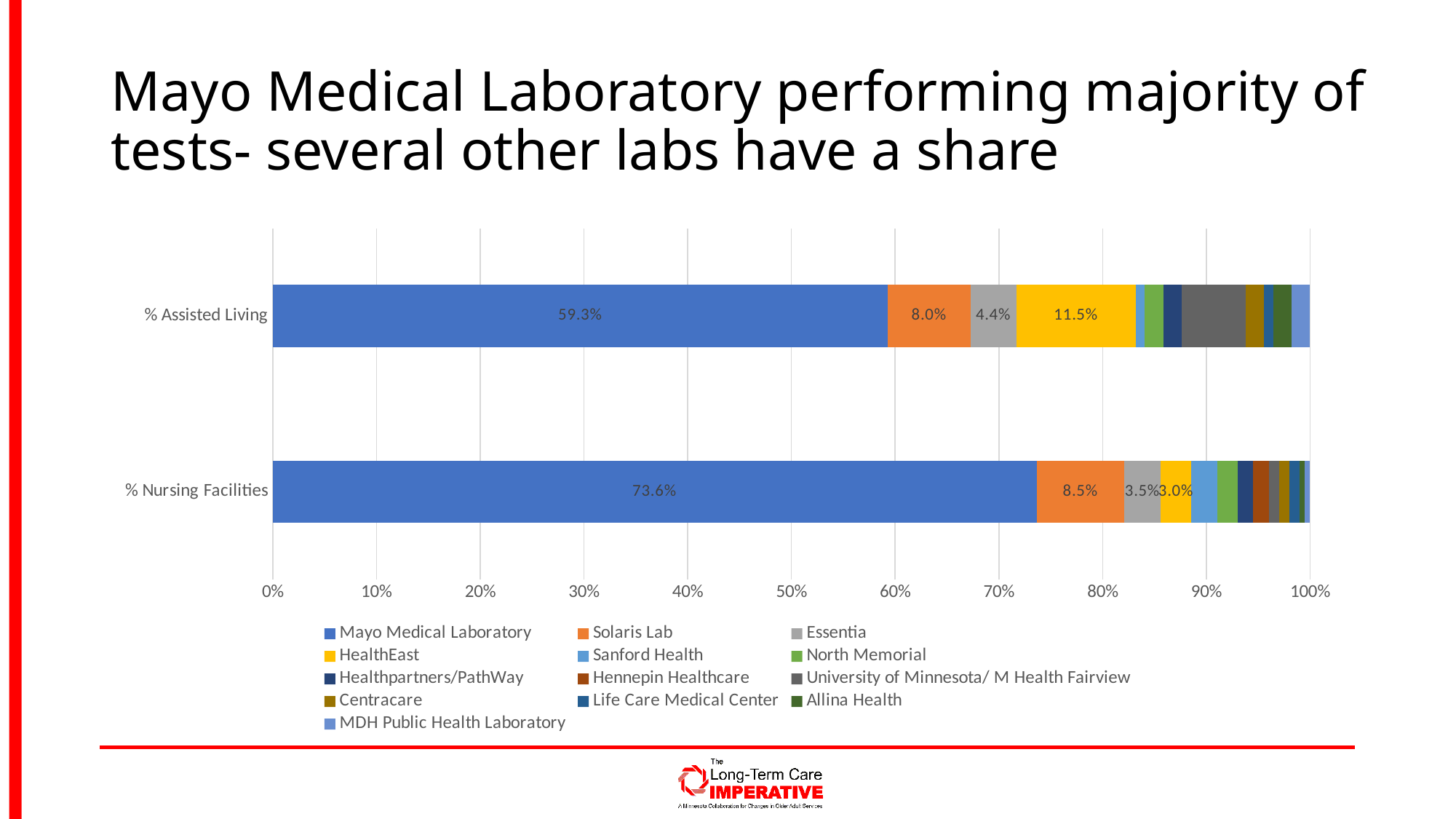
Which series is shown in yellow in the legend? HealthEast What is the value for Mayo Medical Laboratory in the % Nursing Facilities bar? 73.6% Is the Mayo Medical Laboratory value for % Nursing Facilities greater or less than 70%? greater Which category has the larger HealthEast value, % Assisted Living or % Nursing Facilities? % Assisted Living What is the value for HealthEast in the % Assisted Living bar? 11.5% What is the value for Essentia in the % Assisted Living bar? 4.4% What kind of chart is shown on the slide? Stacked bar chart How many series does the legend list? 13 What is the value for Solaris Lab in the % Nursing Facilities bar? 8.5% What is the value for Mayo Medical Laboratory in the % Assisted Living bar? 59.3% How many categories (bars) are shown on the chart? 2 What is the difference between the Mayo Medical Laboratory values for % Nursing Facilities and % Assisted Living? 14.3%